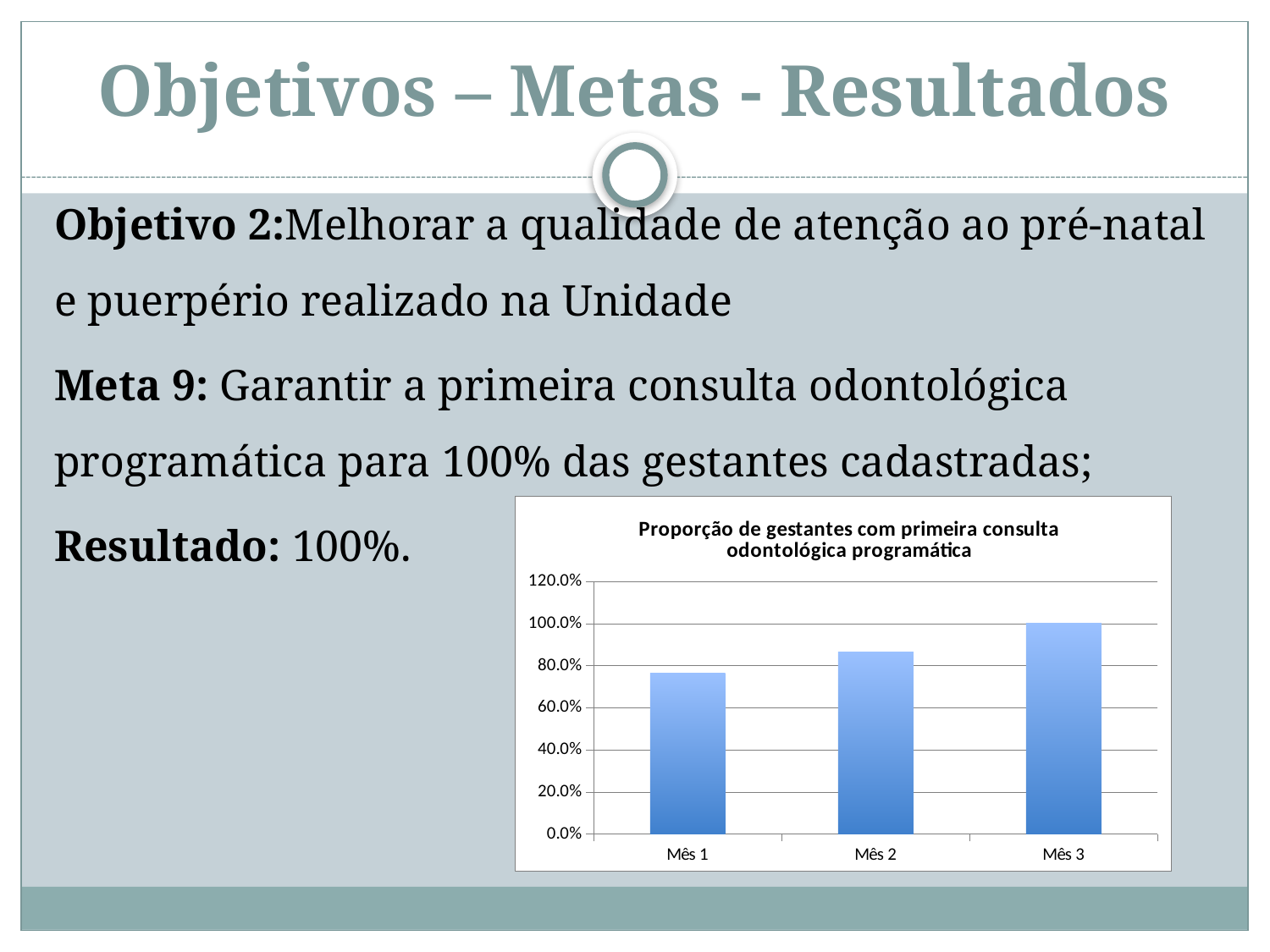
Is the value for Mês 1 greater or less than 80.0%? less What is the value for Mês 3 in the chart? 100.0% Which month has the highest proportion in the chart? Mês 3 Which month has the lowest proportion in the chart? Mês 1 Is the value for Mês 2 greater or less than 80.0%? greater What is the highest value shown on the chart's vertical axis? 120.0% Do the values rise or fall from Mês 1 to Mês 3? rise What kind of chart is shown on the slide? bar chart Is the value for Mês 1 greater or less than 60.0%? greater What is the title of the chart? Proporção de gestantes com primeira consulta odontológica programática How many categories (months) are plotted in the chart? 3 Which is larger, the value for Mês 1 or the value for Mês 2? Mês 2